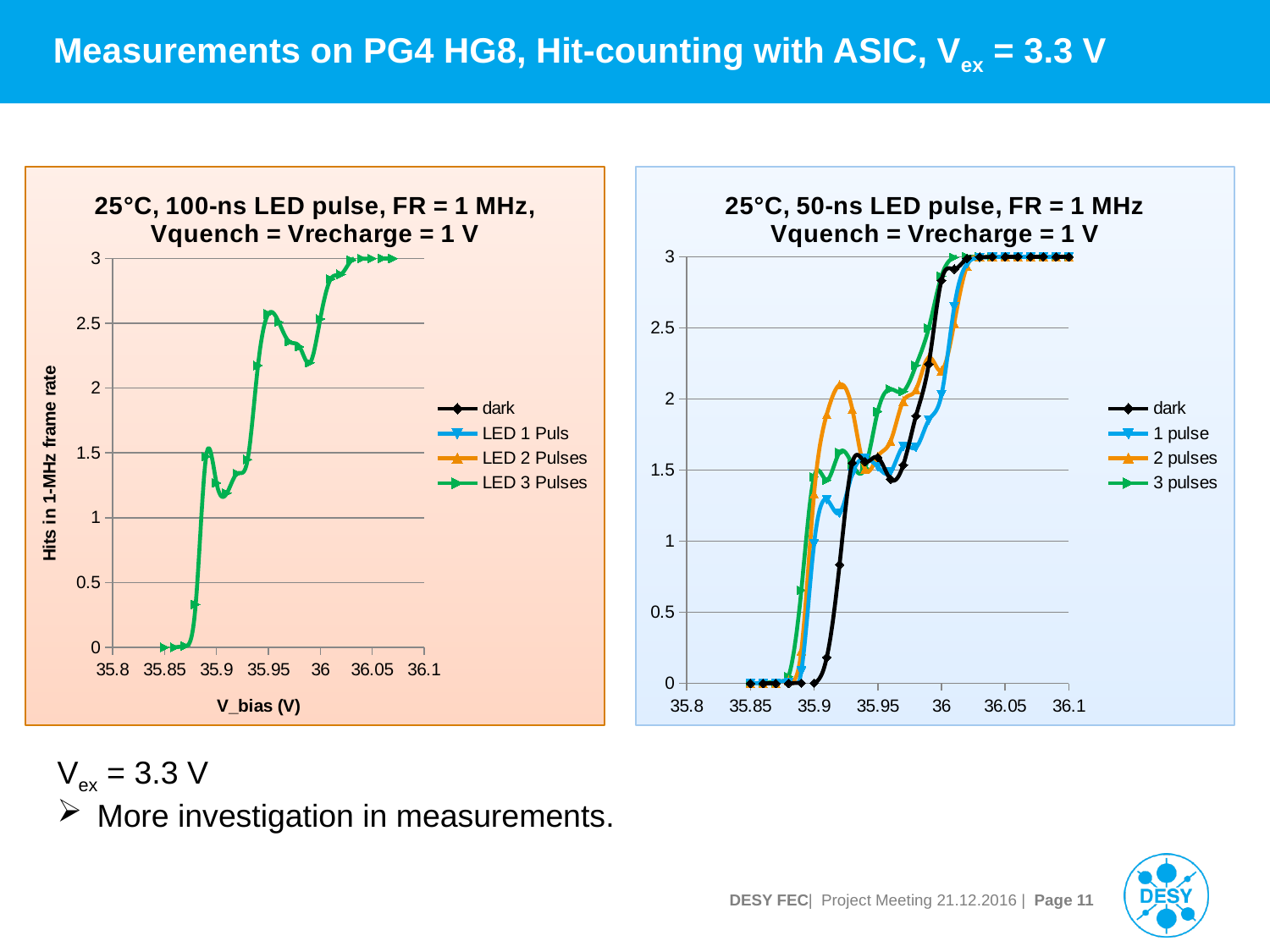
In the right chart, is the value of the dark series at 35.9 greater or less than 0.5? less How many series does the legend of the right chart list? 4 In the right chart, is the value of the 3 pulses series at 36.05 greater or less than 2.5? greater How many series does the legend of the left chart list? 4 In the left chart, is the value of LED 3 Pulses at V_bias = 35.85 greater or less than 0.5? less In the left chart, do the LED 3 Pulses values overall rise or fall as V_bias increases from 35.85 to 36.05? rise What is the y-axis label of the left chart? Hits in 1-MHz frame rate In the right chart, at 35.9 which series has the larger value, 2 pulses or dark? 2 pulses What kind of chart is the left chart titled "25°C, 100-ns LED pulse, FR = 1 MHz, Vquench = Vrecharge = 1 V"? line chart What kind of chart is the right chart titled "25°C, 50-ns LED pulse, FR = 1 MHz Vquench = Vrecharge = 1 V"? line chart What is the x-axis label of the left chart? V_bias (V)